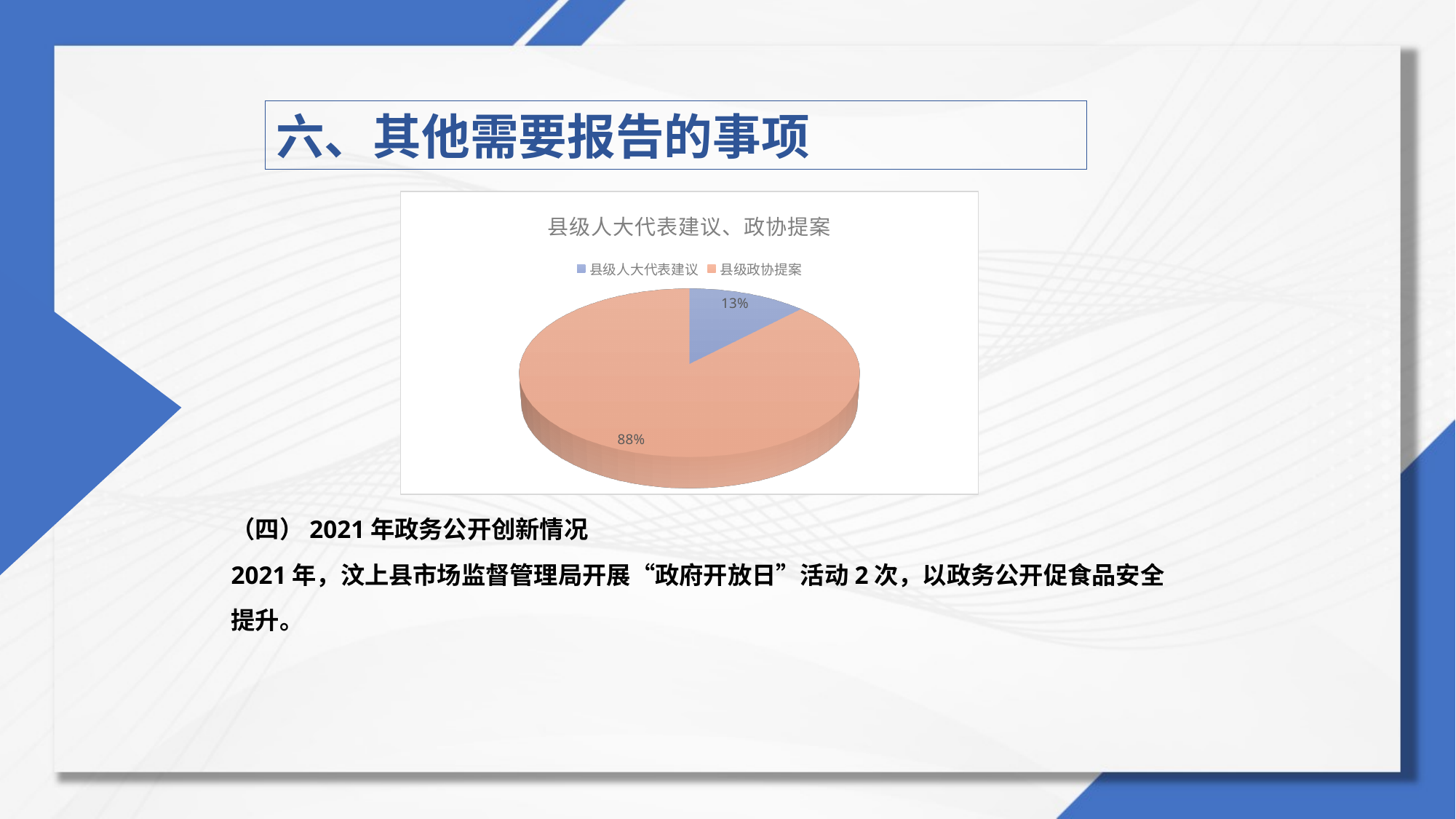
Which is larger, 县级人大代表建议 or 县级政协提案? 县级政协提案 How many series does the legend list? 2 How many slices does the pie chart have? 2 What share of the pie does 县级政协提案 take? 88% What share of the pie does 县级人大代表建议 take? 13% What colour is the 县级政协提案 slice? orange What is the title of the chart? 县级人大代表建议、政协提案 What kind of chart is shown on the slide? pie chart Which slice is the smallest? 县级人大代表建议 Which slice is the largest? 县级政协提案 What is the difference in percentage points between the 县级政协提案 slice and the 县级人大代表建议 slice? 75